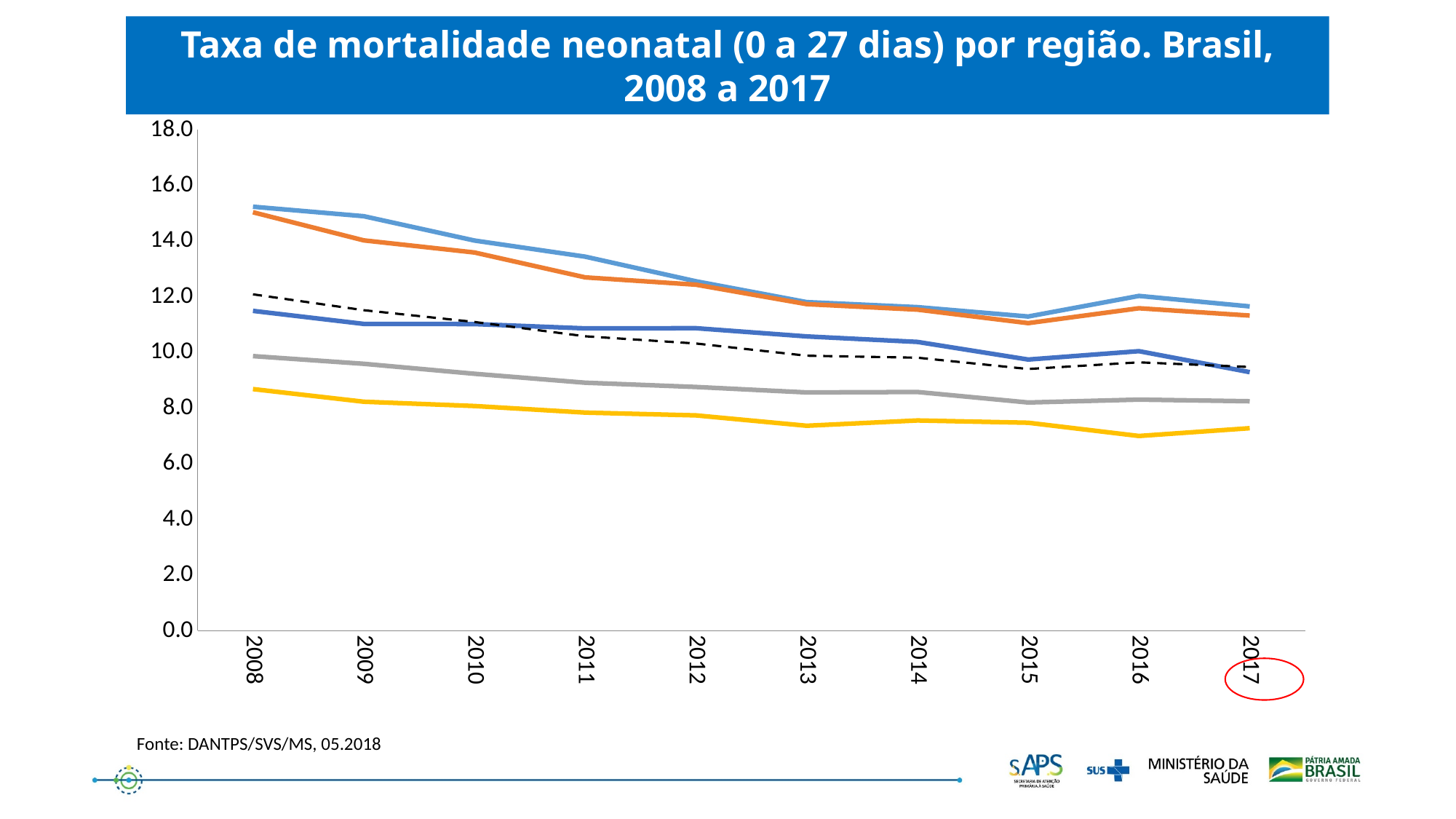
Is the value of the light blue line in 2008 greater or less than 14.0? greater What kind of chart is shown on the slide? line chart Do the values of the orange line generally rise or fall from 2008 to 2017? fall Is the value of the grey line in 2017 greater or less than 10.0? less In 2008, which line has the larger value, the light blue line or the yellow line? the light blue line In which year does the light blue line reach its highest value? 2008 How many lines are plotted on the chart? 6 Is the value of the yellow line in 2016 greater or less than 8.0? less How many years are shown along the x axis of the chart? 10 What is the source cited below the chart? Fonte: DANTPS/SVS/MS, 05.2018 What is the title of the chart? Taxa de mortalidade neonatal (0 a 27 dias) por região. Brasil, 2008 a 2017